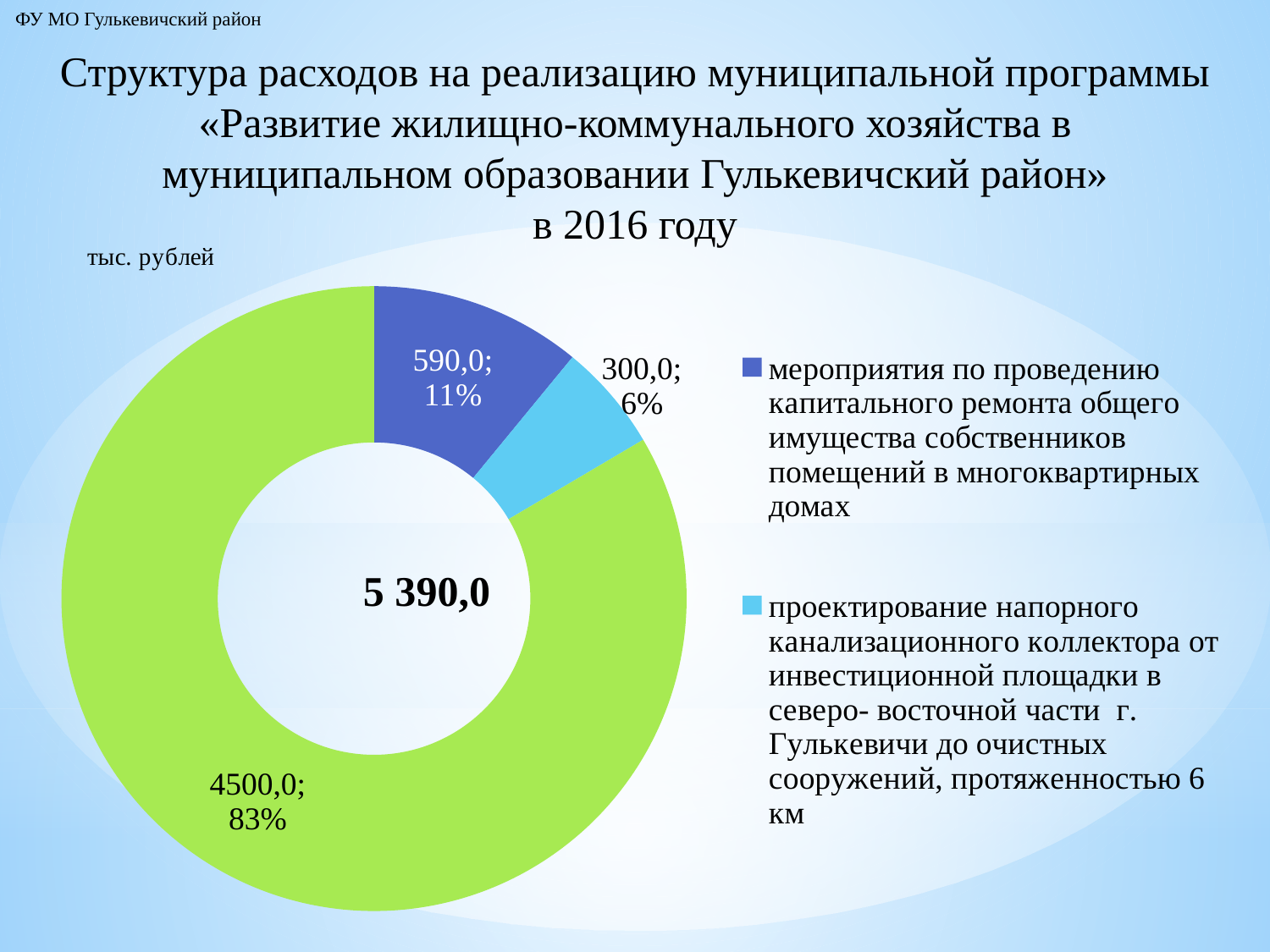
How many entries does the legend list? 2 What is the value for the slice 'мероприятия по проведению капитального ремонта общего имущества собственников помещений в многоквартирных домах'? 590,0 What share of the pie does the slice for 'проектирование напорного канализационного коллектора' represent? 6% What kind of chart is shown on the slide? Pie (donut) chart What is the value for the slice 'проектирование напорного канализационного коллектора'? 300,0 Which legend category has the smallest slice? проектирование напорного канализационного коллектора What share of the pie does the slice for 'мероприятия по проведению капитального ремонта' represent? 11% Which is larger: the slice for 'мероприятия по проведению капитального ремонта' or the slice for 'проектирование напорного канализационного коллектора'? мероприятия по проведению капитального ремонта What is the value of the largest slice in the chart? 4500,0 What total value is shown in the centre of the donut chart? 5 390,0 How many slices does the pie chart have? 3 What is the difference between the slice for 'мероприятия по проведению капитального ремонта' (590,0) and the slice for 'проектирование напорного канализационного коллектора' (300,0)? 290,0